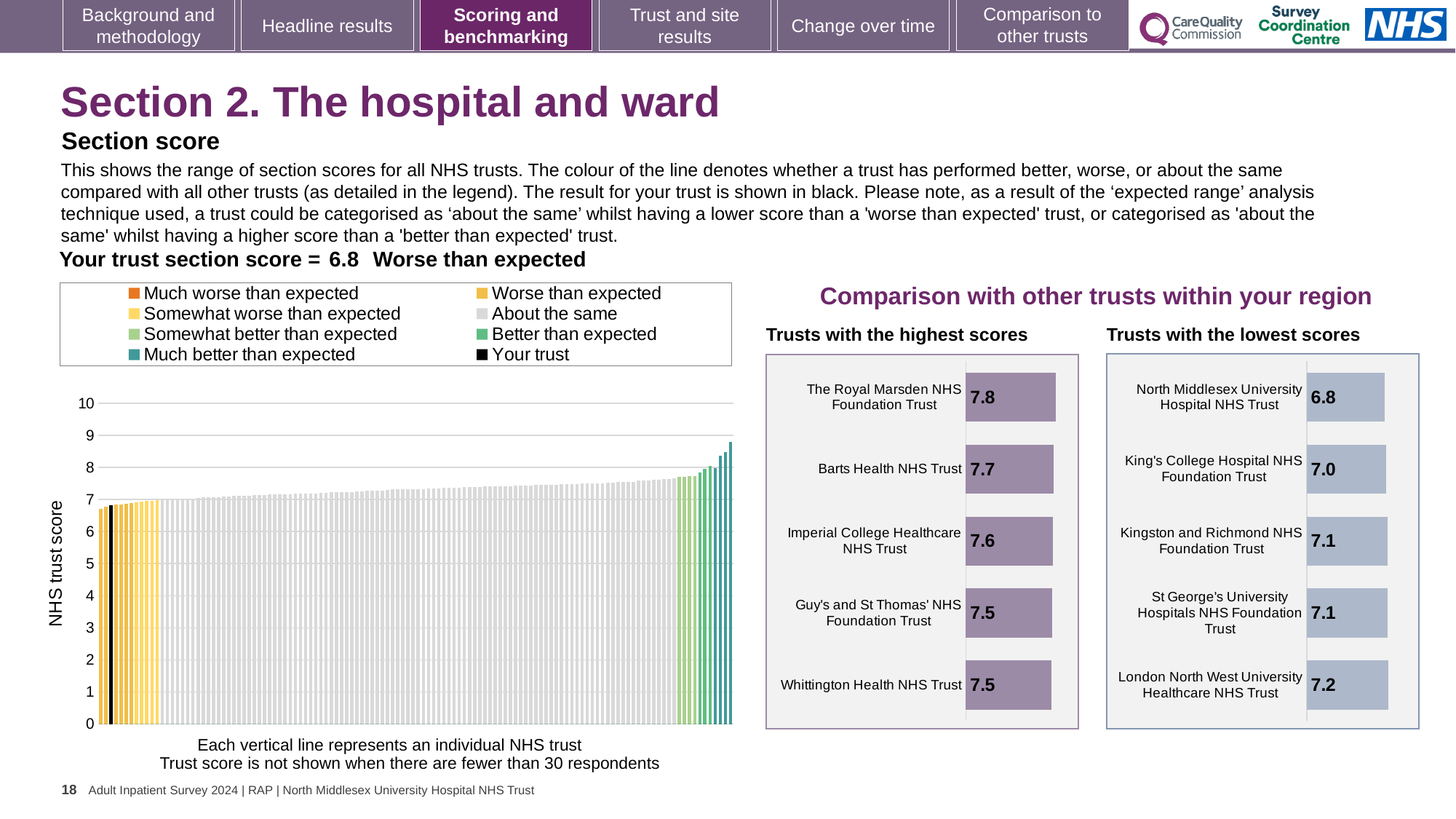
What kind of chart is the 'Trusts with the highest scores' chart? Bar chart In the 'Trusts with the highest scores' chart, which has the larger score: Barts Health NHS Trust or Imperial College Healthcare NHS Trust? Barts Health NHS Trust What is the y-axis label of the large chart on the left showing all NHS trusts? NHS trust score In the 'Trusts with the highest scores' chart, which trust has the highest score? The Royal Marsden NHS Foundation Trust In the 'Trusts with the lowest scores' chart, what is the difference between the scores of London North West University Healthcare NHS Trust and North Middlesex University Hospital NHS Trust? 0.4 In the 'Trusts with the highest scores' chart, what is the difference between the scores of The Royal Marsden NHS Foundation Trust and Whittington Health NHS Trust? 0.3 In the large chart on the left showing all NHS trusts, do the bars rise or fall from left to right? Rise In the large chart on the left showing all NHS trusts, is the value of the tallest bar greater or less than 8? greater In the 'Trusts with the lowest scores' chart, what is the score for King's College Hospital NHS Foundation Trust? 7.0 In the 'Trusts with the lowest scores' chart, which trust has the lowest score? North Middlesex University Hospital NHS Trust In the 'Trusts with the highest scores' chart, what is the score for The Royal Marsden NHS Foundation Trust? 7.8 How many trusts are shown in the 'Trusts with the lowest scores' chart? 5